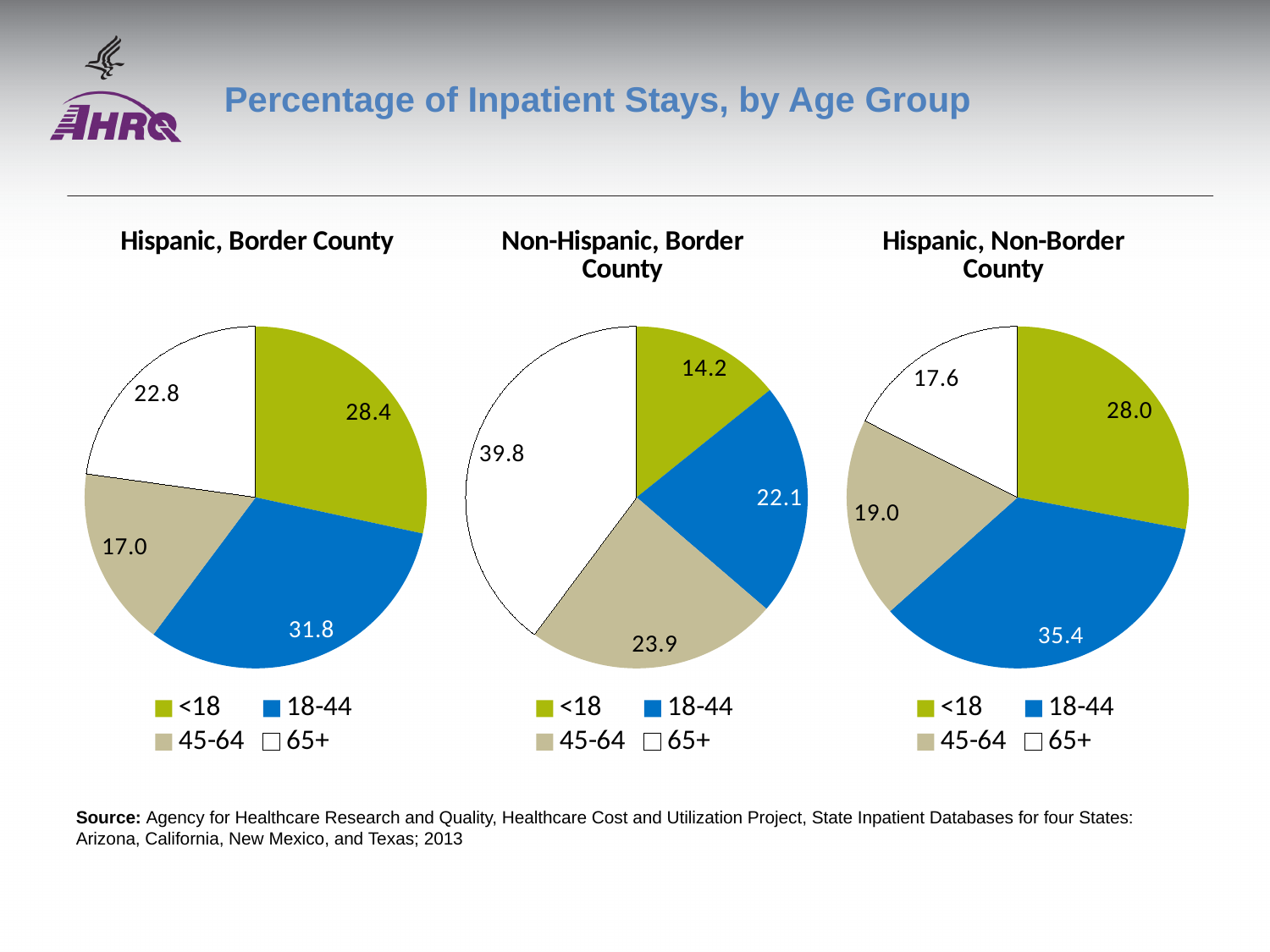
In the Hispanic, Non-Border County chart, what is the value for the 45-64 age group? 19.0 In the Hispanic, Non-Border County chart, which is larger: the <18 slice or the 65+ slice? <18 What colour represents the 18-44 age group in the charts? Blue In the Non-Hispanic, Border County chart, what is the value for the 65+ age group? 39.8 In the Non-Hispanic, Border County chart, which age group has the smallest slice? <18 In the Hispanic, Border County chart, what is the difference between the 18-44 and 45-64 values? 14.8 In the Hispanic, Non-Border County chart, which age group has the largest slice? 18-44 How many age groups does the legend of each chart list? 4 In the Hispanic, Border County chart, which age group has the smallest slice? 45-64 What kind of chart is used on this slide? Pie chart In the Hispanic, Border County chart, what is the value for the 18-44 age group? 31.8 In the Non-Hispanic, Border County chart, what is the difference between the 65+ and <18 values? 25.6